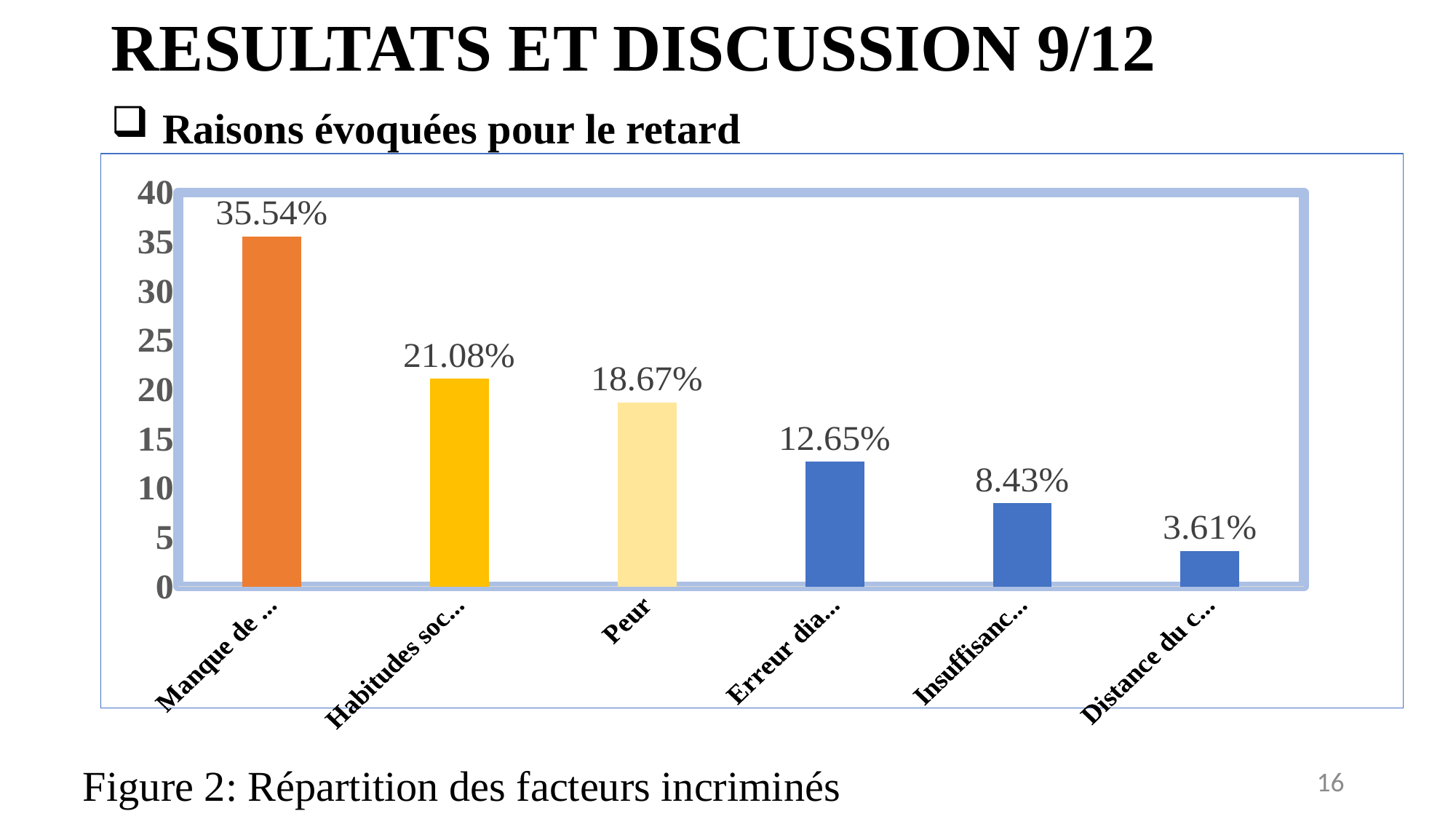
Do the values rise or fall from left to right along the x axis? fall How many bars (categories) does the chart show? 6 Which is larger, the value for Peur or the value of the fourth bar (12.65%)? Peur What is the caption given below the chart? Figure 2: Répartition des facteurs incriminés What is the lowest value shown in the chart? 3.61% What is the difference between the first bar (35.54%) and the second bar (21.08%)? 14.46% What kind of chart is shown on the slide? bar chart What is the value of the last (rightmost) bar? 3.61% Is the value for Peur greater or less than 20? less What is the value of the first (leftmost) bar? 35.54% What is the value for Peur? 18.67% What is the highest value shown in the chart? 35.54%